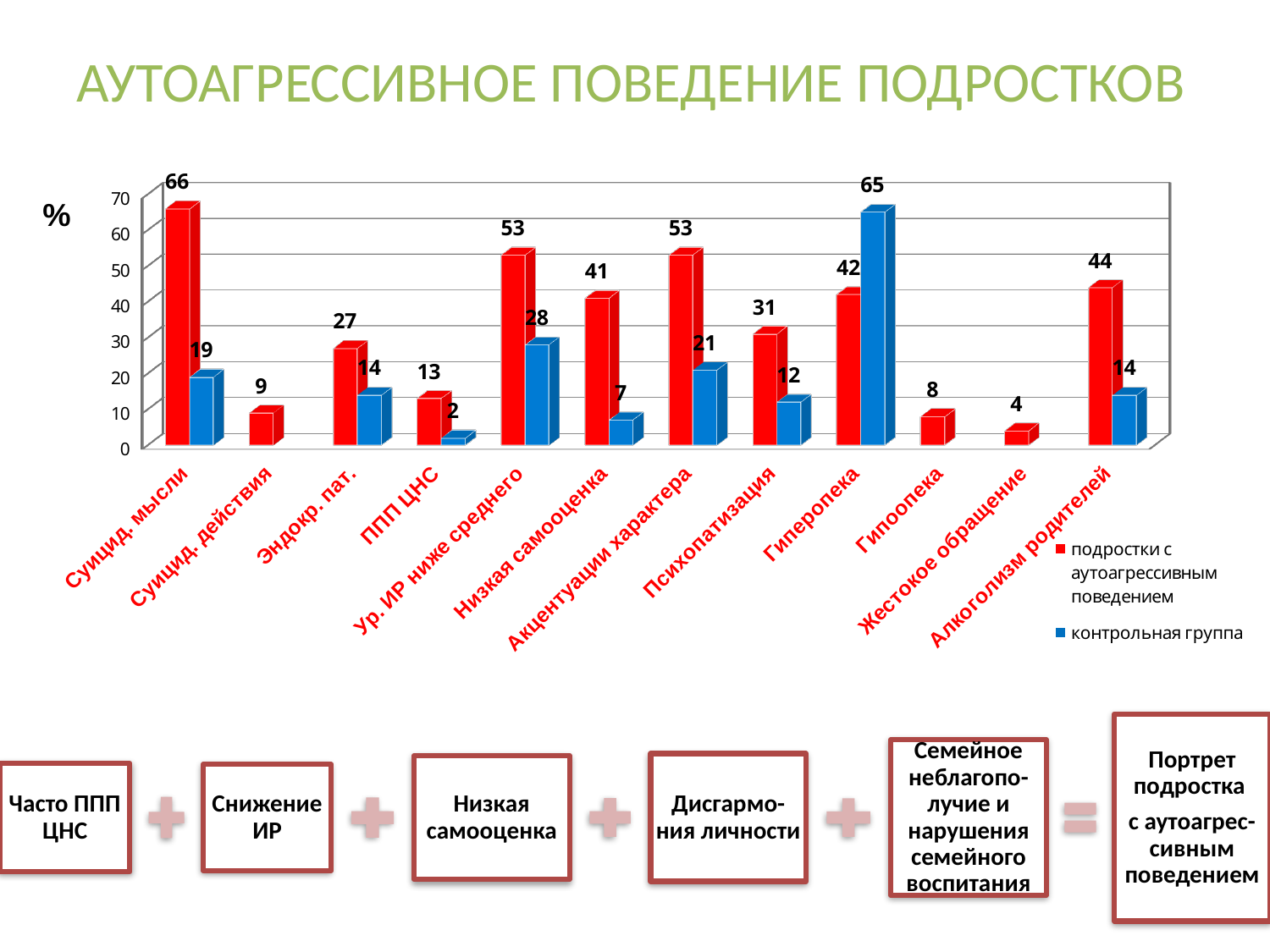
Which category has the highest value in the 'контрольная группа' series? Гиперопека Which category has the highest value in the 'подростки с аутоагрессивным поведением' series? Суицид. мысли What kind of chart is shown on the slide? bar chart How many series does the legend list? 2 For 'Гиперопека', which series has the larger value? контрольная группа What is the value for 'Гиперопека' in the 'контрольная группа' series? 65 What is the difference between the two series for 'Суицид. мысли'? 47 What is the value for 'Суицид. мысли' in the 'подростки с аутоагрессивным поведением' series? 66 What colour represents the 'контрольная группа' series? blue Which category has the lowest value in the 'подростки с аутоагрессивным поведением' series? Жестокое обращение How many categories are shown on the x axis? 12 What is the value for 'Алкоголизм родителей' in the 'подростки с аутоагрессивным поведением' series? 44